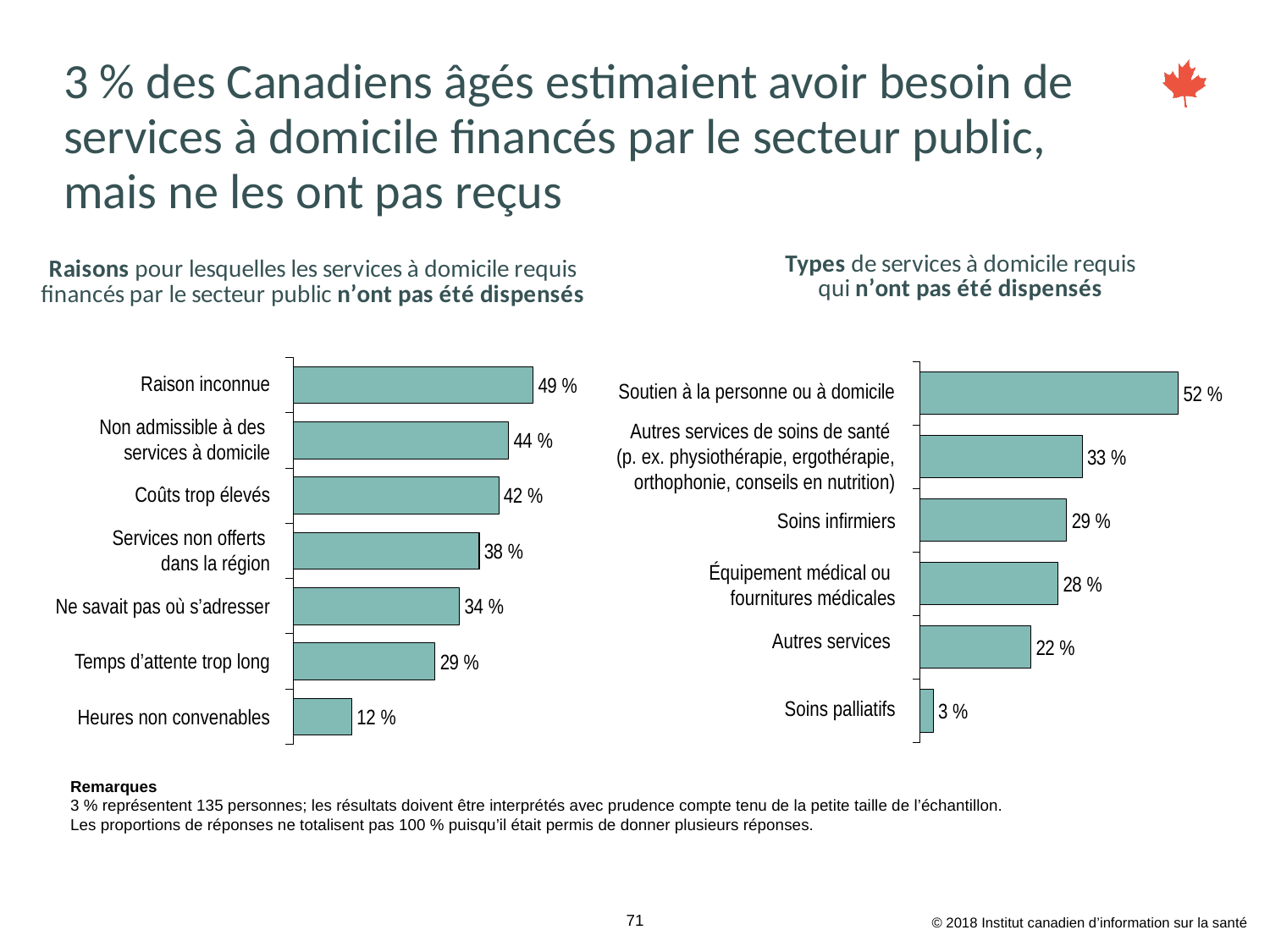
In the left chart (Raisons pour lesquelles les services à domicile requis financés par le secteur public n'ont pas été dispensés), what is the value for Coûts trop élevés? 42 % In the left chart (Raisons), how many categories are shown? 7 In the left chart (Raisons), which category has the lowest value? Heures non convenables In the left chart (Raisons), which category has the highest value? Raison inconnue In the right chart (Types), which category has the lowest value? Soins palliatifs In the right chart (Types), how many categories are shown? 6 In the right chart (Types de services à domicile requis qui n'ont pas été dispensés), what is the value for Soins infirmiers? 29 % In the right chart (Types), what is the difference between Soutien à la personne ou à domicile and Autres services? 30 % In the right chart (Types), which is larger: Équipement médical ou fournitures médicales or Autres services? Équipement médical ou fournitures médicales What type of chart is the left chart (Raisons)? Bar chart In the left chart (Raisons), what is the difference between Raison inconnue and Temps d'attente trop long? 20 % In the right chart (Types), which category has the highest value? Soutien à la personne ou à domicile